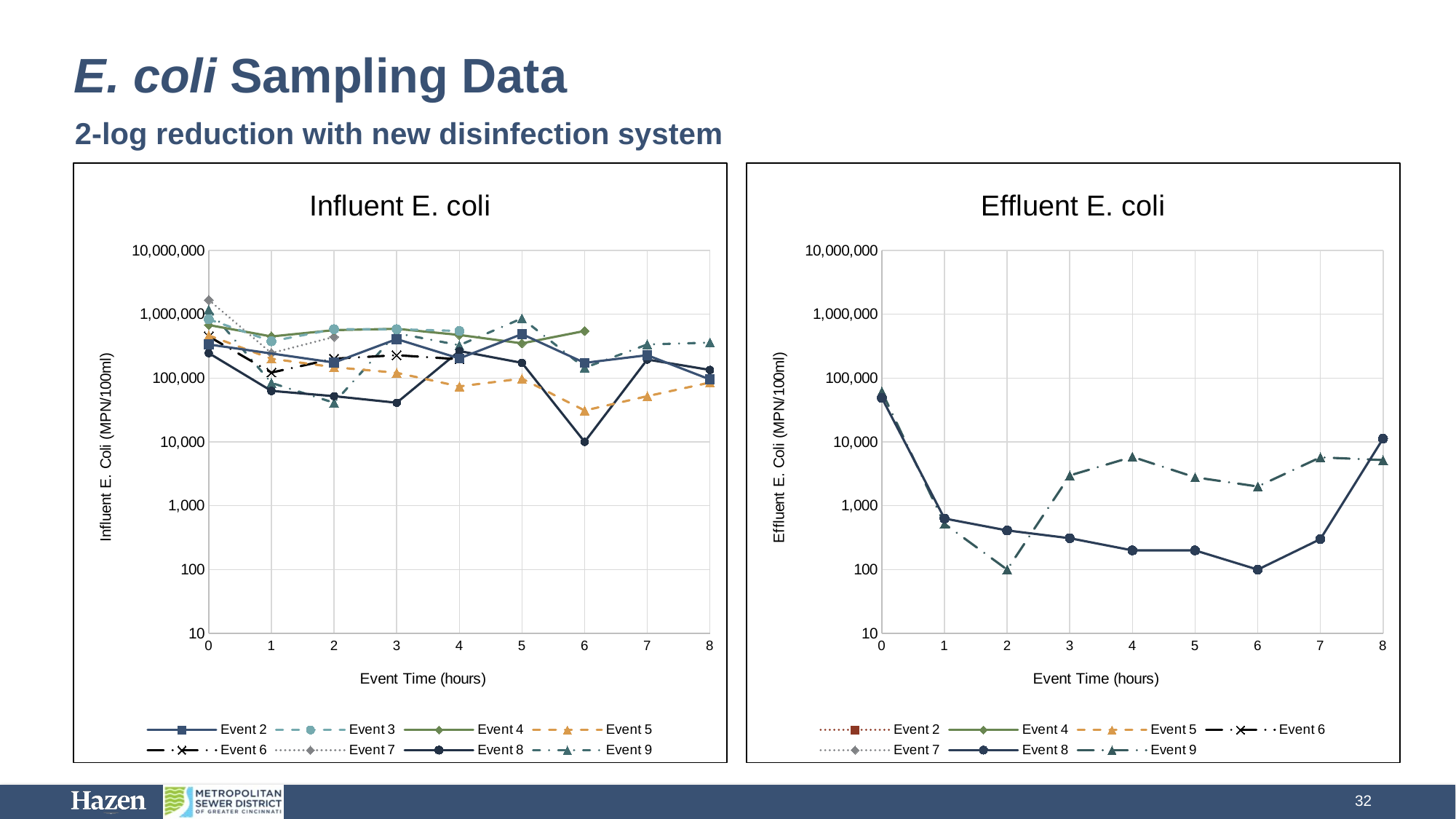
In the Effluent E. coli chart, is the value for Event 8 at hour 0 greater or less than 10,000? greater In the Influent E. coli chart, is the value for Event 7 at hour 0 greater or less than 1,000,000? greater What kind of chart is the Influent E. coli chart? line chart In the Influent E. coli chart, which is larger at hour 6, Event 4 or Event 8? Event 4 In the Influent E. coli chart, is the value for Event 5 at hour 6 greater or less than 100,000? less What is the x-axis label of the Influent E. coli chart? Event Time (hours) In the Effluent E. coli chart, which is larger at hour 6, Event 8 or Event 9? Event 9 How many series does the legend of the Influent E. coli chart list? 8 What is the y-axis label of the Effluent E. coli chart? Effluent E. Coli (MPN/100ml) In the Effluent E. coli chart, does the Event 8 line rise or fall from hour 0 to hour 1? fall How many series does the legend of the Effluent E. coli chart list? 7